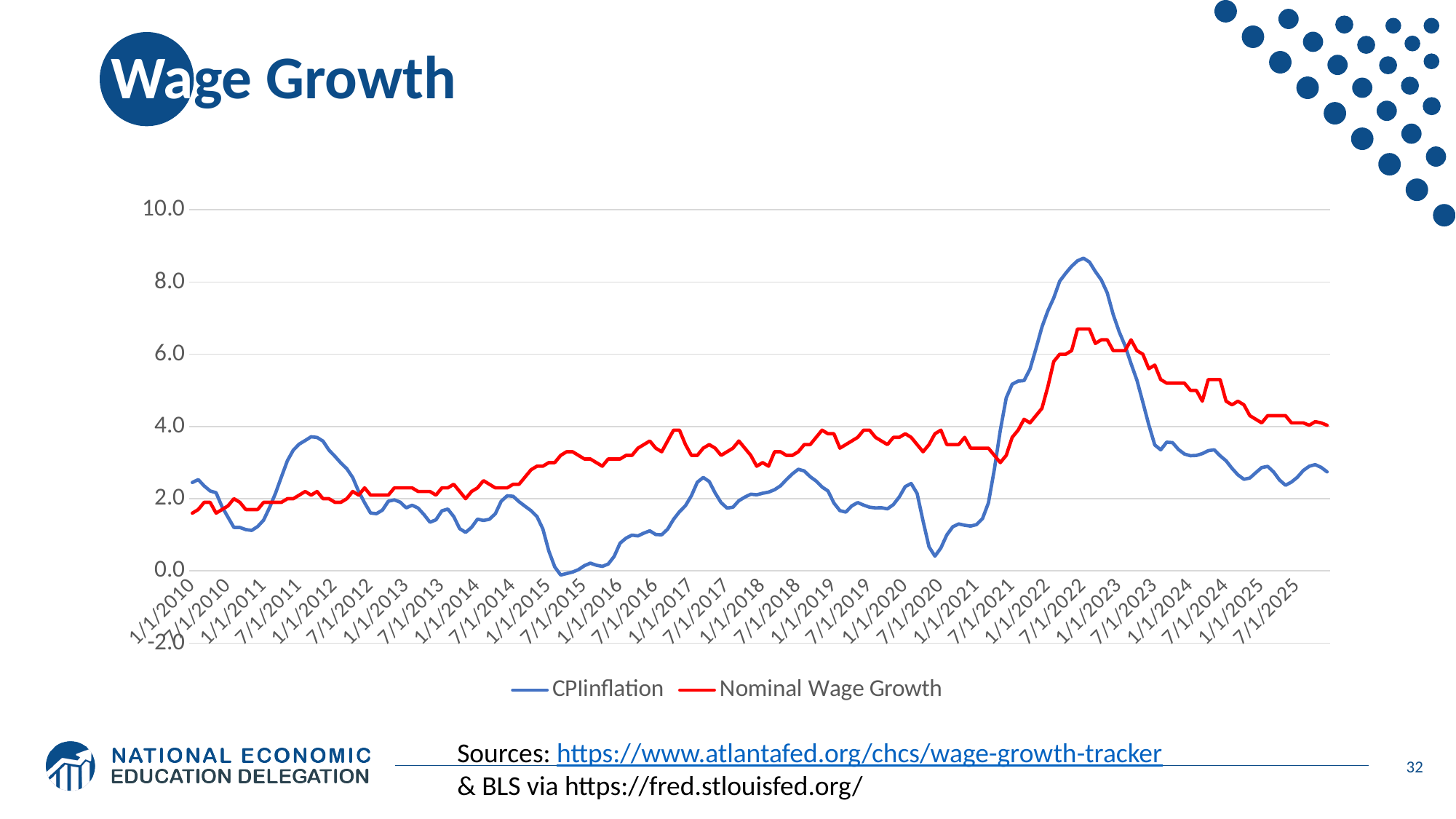
At 7/1/2022, which series has the higher value, CPIinflation or Nominal Wage Growth? CPIinflation What is the title of the slide containing the chart? Wage Growth At 1/1/2024, which series has the higher value, CPIinflation or Nominal Wage Growth? Nominal Wage Growth Does CPIinflation rise or fall between 7/1/2022 and 7/1/2023? fall Is the value of CPIinflation at 7/1/2020 greater or less than 2.0? less Is the peak value of CPIinflation around 7/1/2022 greater or less than 8.0? greater What kind of chart is shown on the slide? line chart Is the value of Nominal Wage Growth at 1/1/2024 greater or less than 4.0? greater Which series is drawn in red? Nominal Wage Growth Which series reaches the highest peak on the chart? CPIinflation How many series does the legend list? 2